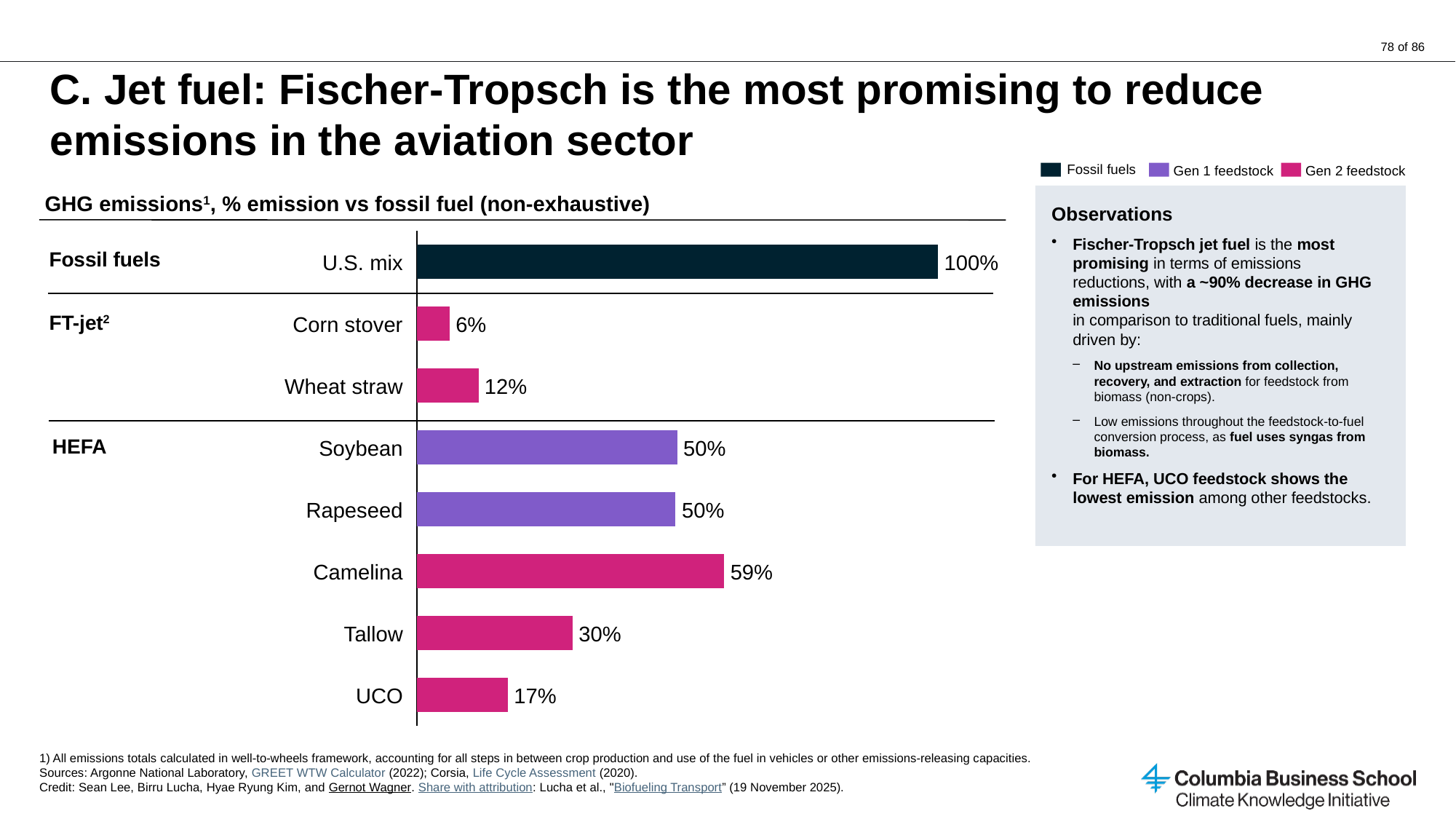
How many series does the legend list? 3 What kind of chart is shown on the slide? Bar chart What is the GHG emissions value for Corn stover? 6% What is the difference between the values for Camelina and Tallow? 29% What is the GHG emissions value for Camelina? 59% Which category has the lowest GHG emissions value? Corn stover How many categories (bars) are shown in the chart? 8 What is the GHG emissions value for UCO? 17% Which legend entry is shown in purple? Gen 1 feedstock Which category has the highest GHG emissions value? U.S. mix What is the difference between the values for Wheat straw and Corn stover? 6% Which has a larger value, Tallow or UCO? Tallow